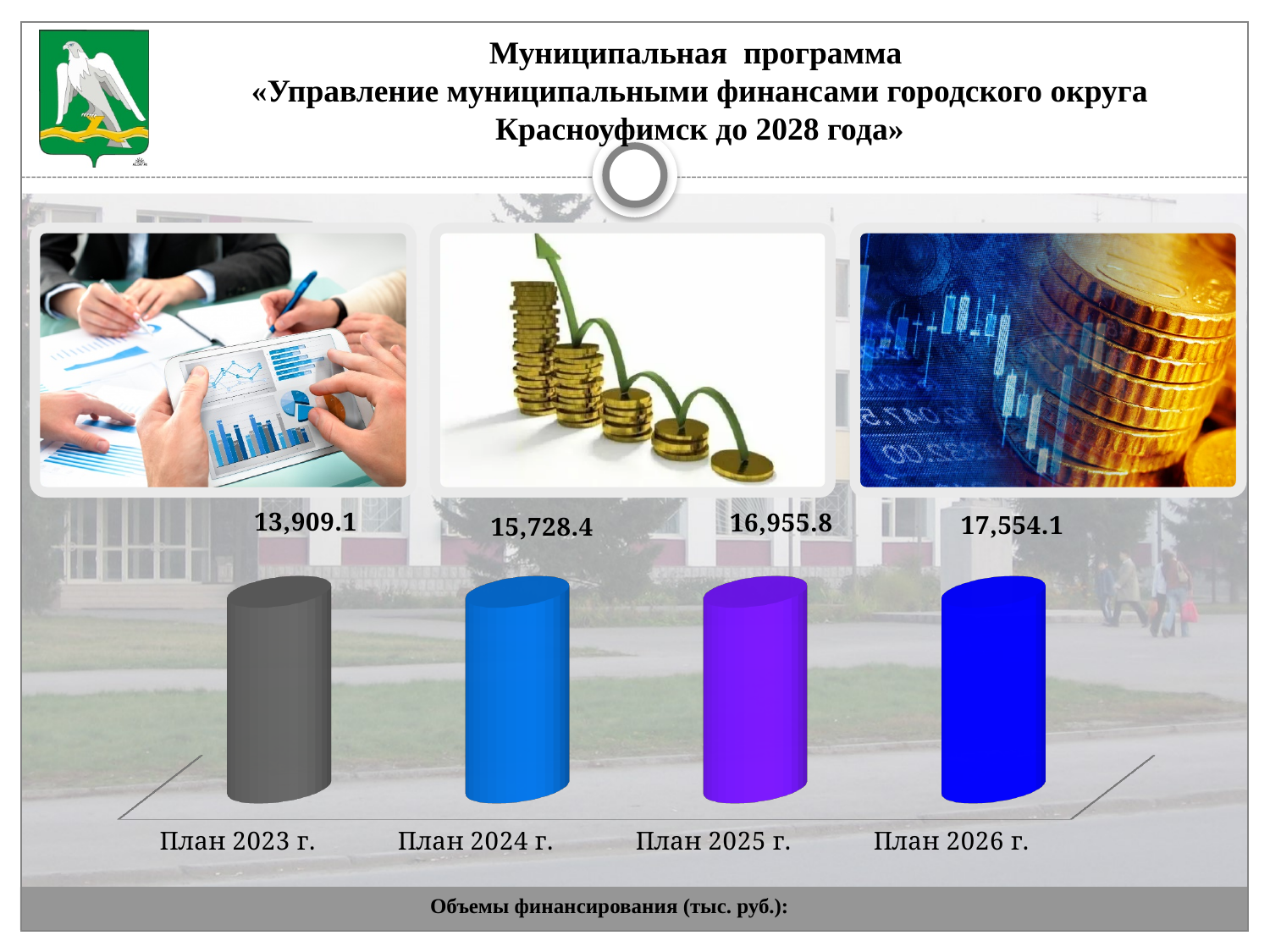
What kind of chart is shown on the slide? Bar chart What is the difference between the values for План 2026 г. and План 2025 г.? 598.3 Which category has the highest value? План 2026 г. Which category has the lowest value? План 2023 г. Do the values rise or fall from План 2023 г. to План 2026 г.? Rise Which is larger, the value for План 2025 г. or the value for План 2024 г.? План 2025 г. What is the value for План 2023 г.? 13,909.1 What is the difference between the values for План 2024 г. and План 2023 г.? 1,819.3 What is the value for План 2025 г.? 16,955.8 What is the value for План 2026 г.? 17,554.1 How many categories are shown in the chart? 4 What is the value for План 2024 г.? 15,728.4